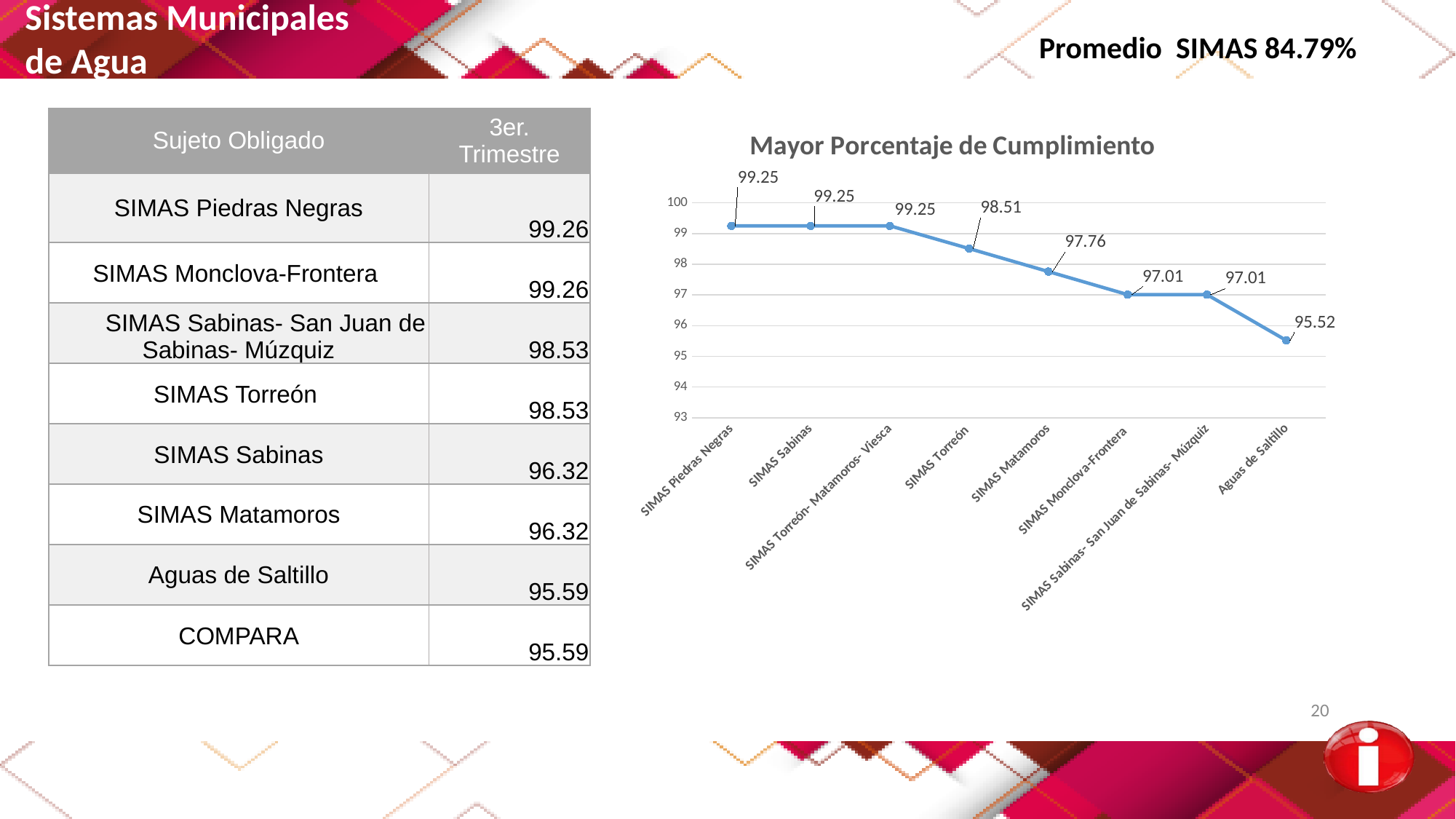
What type of chart is shown under the title "Mayor Porcentaje de Cumplimiento"? line chart In the chart "Mayor Porcentaje de Cumplimiento", which is larger: the value for SIMAS Torreón or the value for SIMAS Monclova-Frontera? SIMAS Torreón In the chart "Mayor Porcentaje de Cumplimiento", what is the value for SIMAS Monclova-Frontera? 97.01 In the chart "Mayor Porcentaje de Cumplimiento", which category has the lowest value? Aguas de Saltillo In the chart "Mayor Porcentaje de Cumplimiento", what is the value for Aguas de Saltillo? 95.52 In the chart "Mayor Porcentaje de Cumplimiento", what is the difference between the values for SIMAS Piedras Negras and Aguas de Saltillo? 3.73 How many categories are plotted in the chart "Mayor Porcentaje de Cumplimiento"? 8 In the chart "Mayor Porcentaje de Cumplimiento", what is the difference between the values for SIMAS Torreón and SIMAS Matamoros? 0.75 In the chart "Mayor Porcentaje de Cumplimiento", do the values rise or fall from left to right along the x axis? fall In the chart "Mayor Porcentaje de Cumplimiento", is the value for Aguas de Saltillo greater or less than 96? less In the chart "Mayor Porcentaje de Cumplimiento", what is the value for SIMAS Torreón? 98.51 In the chart "Mayor Porcentaje de Cumplimiento", what is the value for SIMAS Matamoros? 97.76